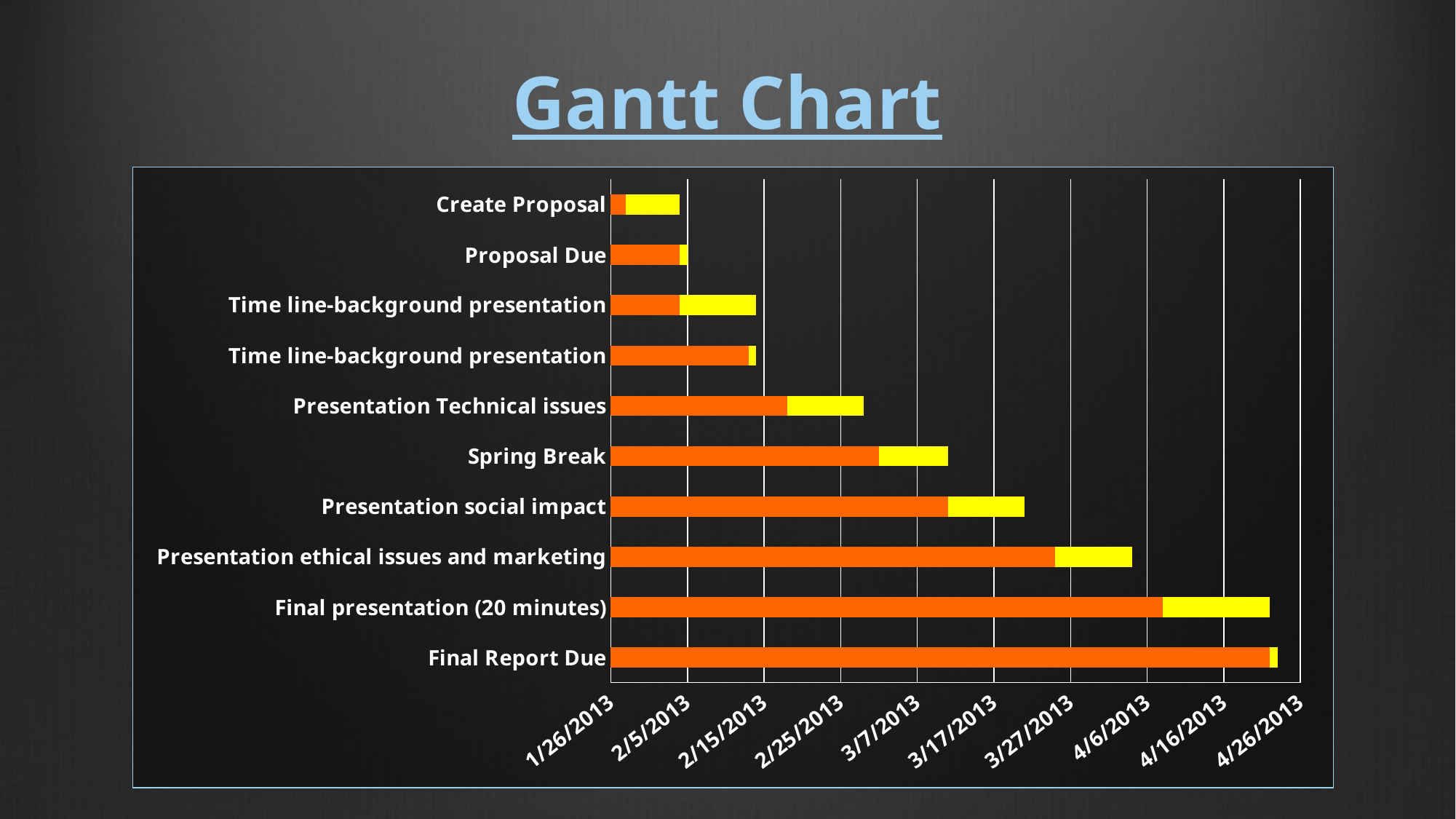
What is the title of the slide? Gantt Chart How many tasks are listed on the vertical axis of the chart? 10 What is the last date shown on the horizontal axis? 4/26/2013 Which bar extends further to the right: Presentation ethical issues and marketing or Final presentation (20 minutes)? Final presentation (20 minutes) What two colours are used for the bar segments in the chart? Orange and yellow Which task's bar extends furthest to the right on the chart? Final Report Due Which bar extends further to the right: Spring Break or Presentation social impact? Presentation social impact What kind of chart is shown on the slide? Bar chart (Gantt chart) What is the first date shown on the horizontal axis? 1/26/2013 Does the bar for Final presentation (20 minutes) end before or after 4/16/2013? after Does the bar for Spring Break end before or after 3/7/2013? after Does the bar for Presentation social impact end before or after 3/27/2013? before